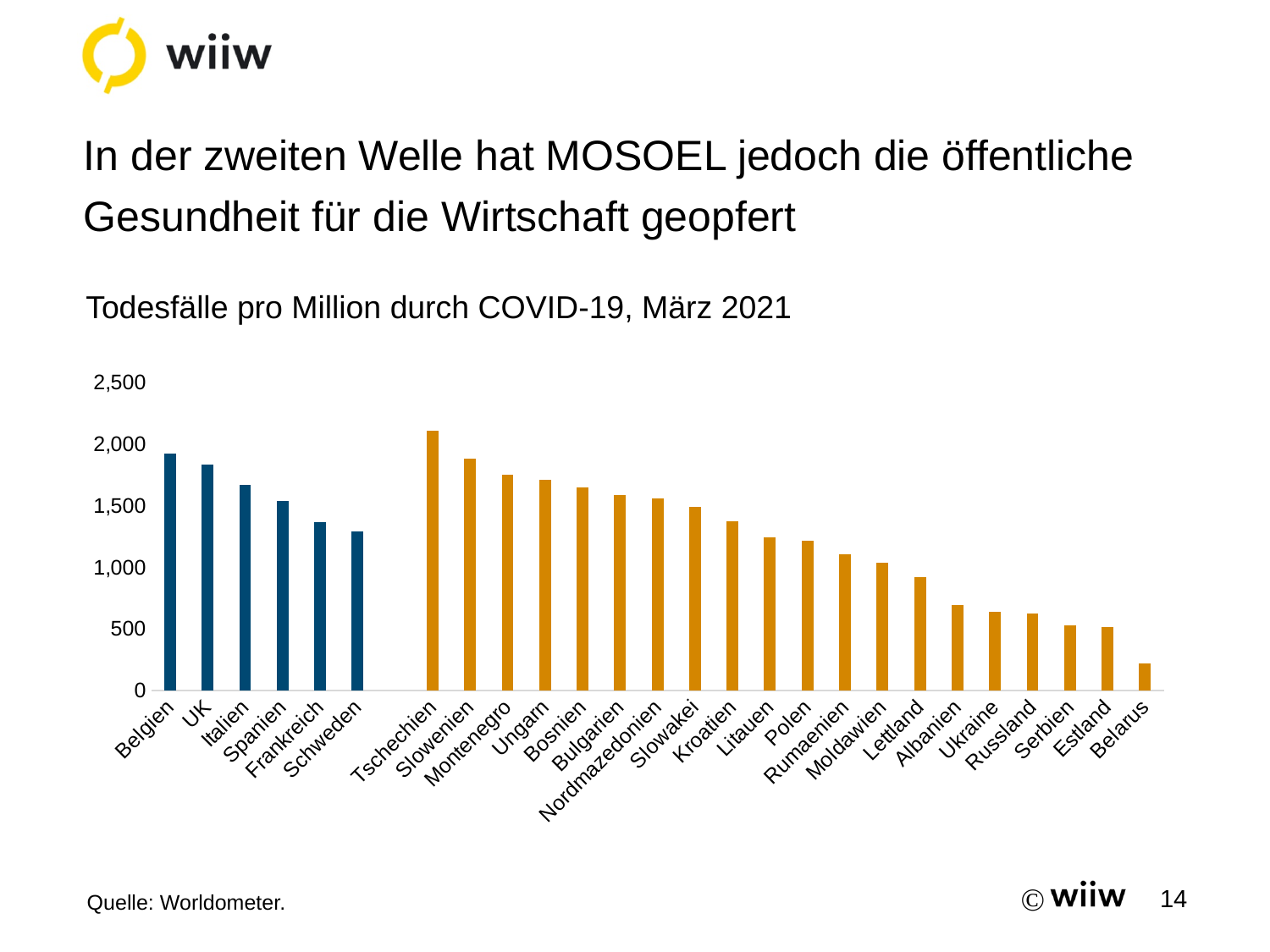
Is the value for Belarus greater or less than 500? less Is the value for Lettland greater or less than 1,000? less Is the value for Schweden greater or less than 1,000? greater What kind of chart is shown on the slide? bar chart Which has the higher value, Tschechien or Belgien? Tschechien How many countries are shown in the chart? 26 Which has the higher value, Estland or Belarus? Estland What is the title of the chart? Todesfälle pro Million durch COVID-19, März 2021 Which country has the lowest deaths per million in the chart? Belarus Do the values of the orange bars rise or fall from left to right? fall Which country has the highest deaths per million in the chart? Tschechien